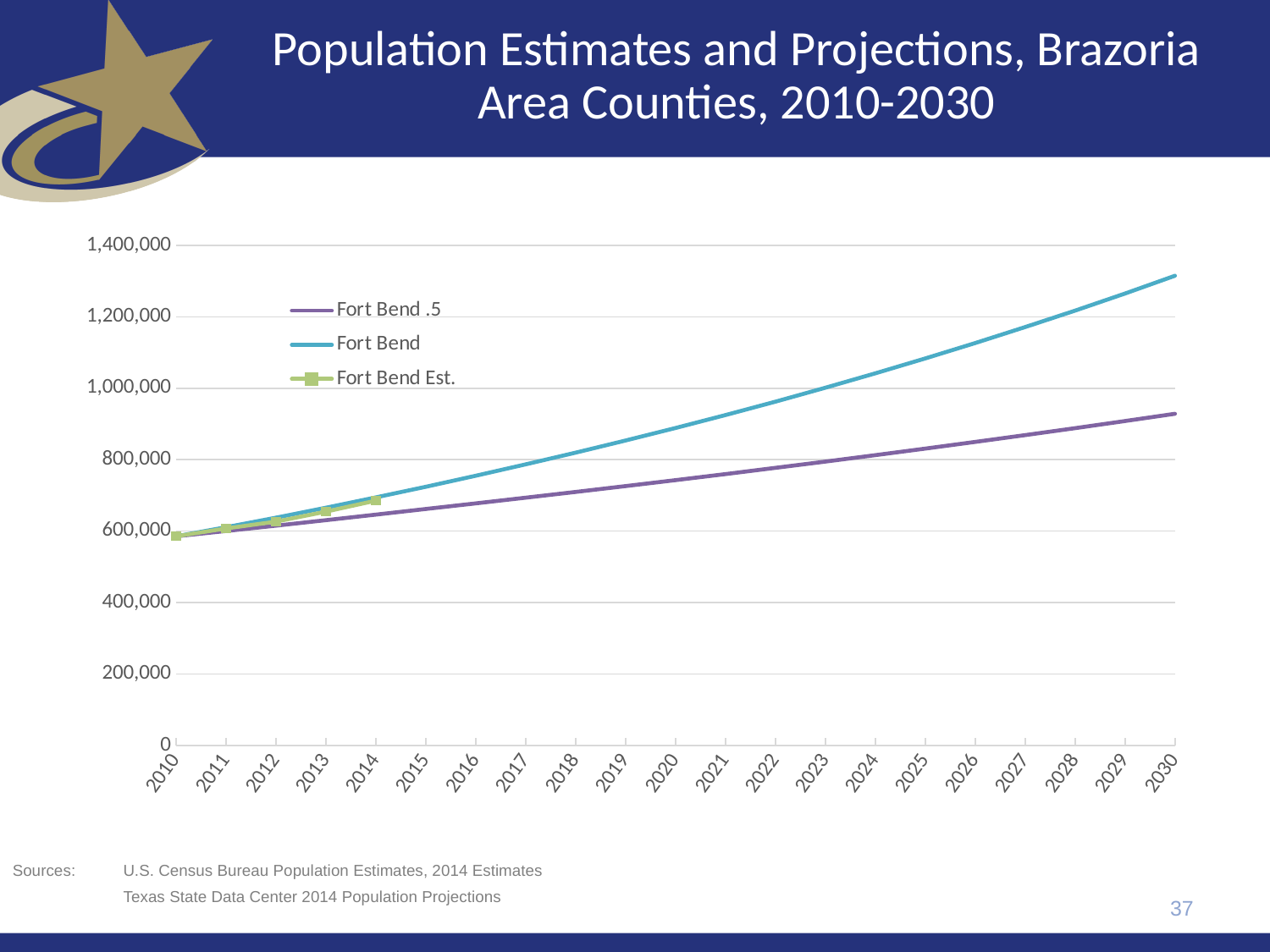
How many years are labelled along the x axis? 21 Is the value for Fort Bend in 2030 greater or less than 1,200,000? greater What is the title of the chart slide? Population Estimates and Projections, Brazoria Area Counties, 2010-2030 How many series does the legend list? 3 Is the value for Fort Bend .5 in 2030 greater or less than 1,000,000? less Does the Fort Bend series rise or fall from 2010 to 2030? rise Is the value for Fort Bend .5 in 2020 greater or less than 800,000? less What kind of chart is shown on the slide? line chart Does the Fort Bend .5 series rise or fall from 2010 to 2030? rise In 2030, which series has the larger value, Fort Bend or Fort Bend .5? Fort Bend How many data points does the Fort Bend Est. series have? 5